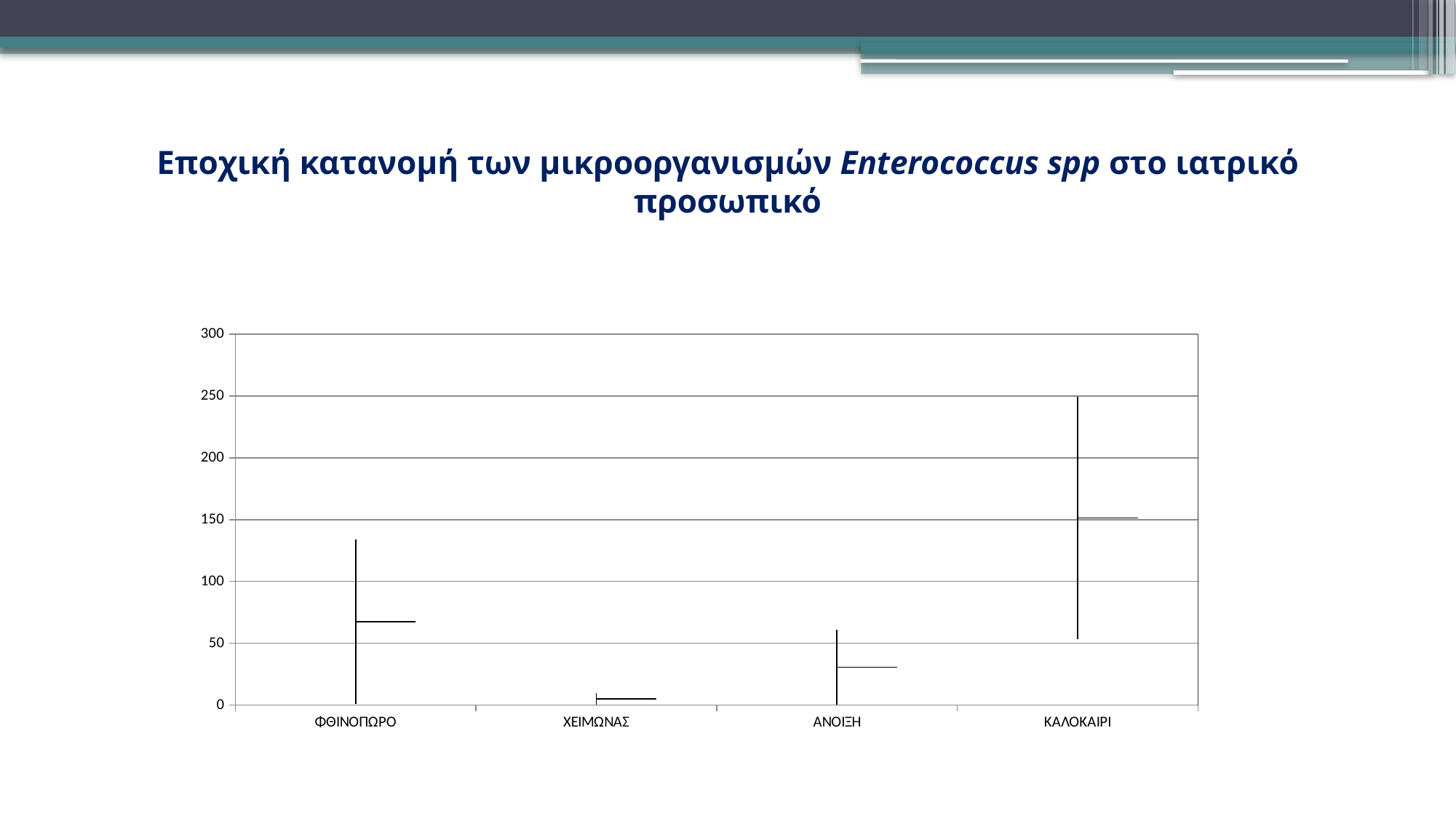
Is the horizontal marker value for ΦΘΙΝΟΠΩΡΟ greater or less than 100? less What is the maximum value shown on the vertical axis of the chart? 300 Which has the larger horizontal marker value, ΦΘΙΝΟΠΩΡΟ or ΑΝΟΙΞΗ? ΦΘΙΝΟΠΩΡΟ Is the top of the vertical line for ΑΝΟΙΞΗ greater or less than 100? less Is the top of the vertical line for ΚΑΛΟΚΑΙΡΙ greater or less than 200? greater Which season has the highest values in the chart? ΚΑΛΟΚΑΙΡΙ Which has the larger horizontal marker value, ΚΑΛΟΚΑΙΡΙ or ΦΘΙΝΟΠΩΡΟ? ΚΑΛΟΚΑΙΡΙ How many seasons (categories) are shown on the x axis of the chart? 4 Which season has the lowest values in the chart? ΧΕΙΜΩΝΑΣ Which microorganism is named in the slide title? Enterococcus spp